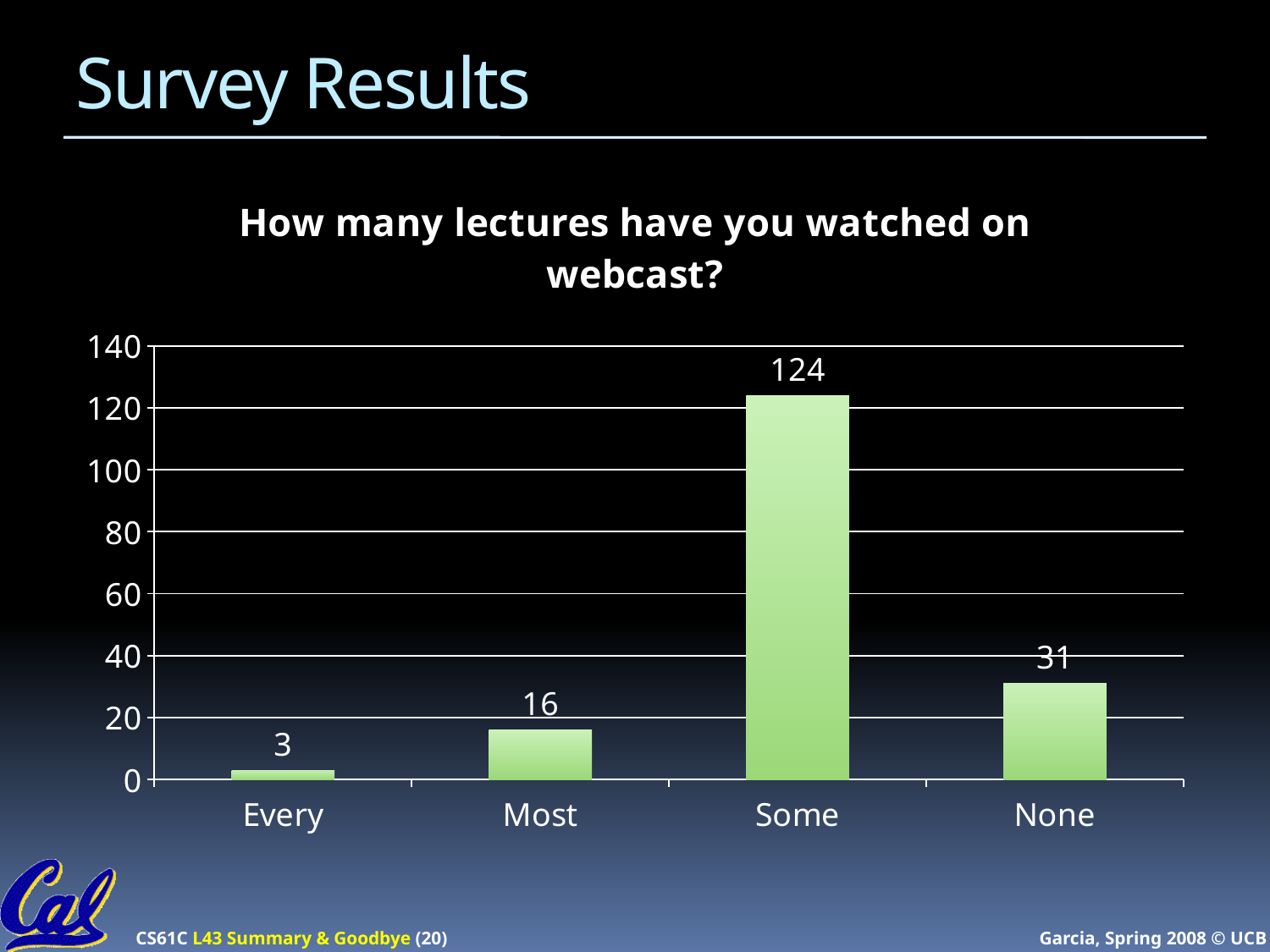
What is the value for Some? 124 What is the value for None? 31 What is the value for Every? 3 What is the difference between the values for Some and None? 93 Which category has the lowest value? Every Which is larger, the value for Most or the value for None? None How many categories are shown on the x axis? 4 What is the difference between the values for None and Most? 15 Which category has the highest value? Some What kind of chart is shown on the slide? bar chart What is the title of the chart? How many lectures have you watched on webcast? What is the value for Most? 16